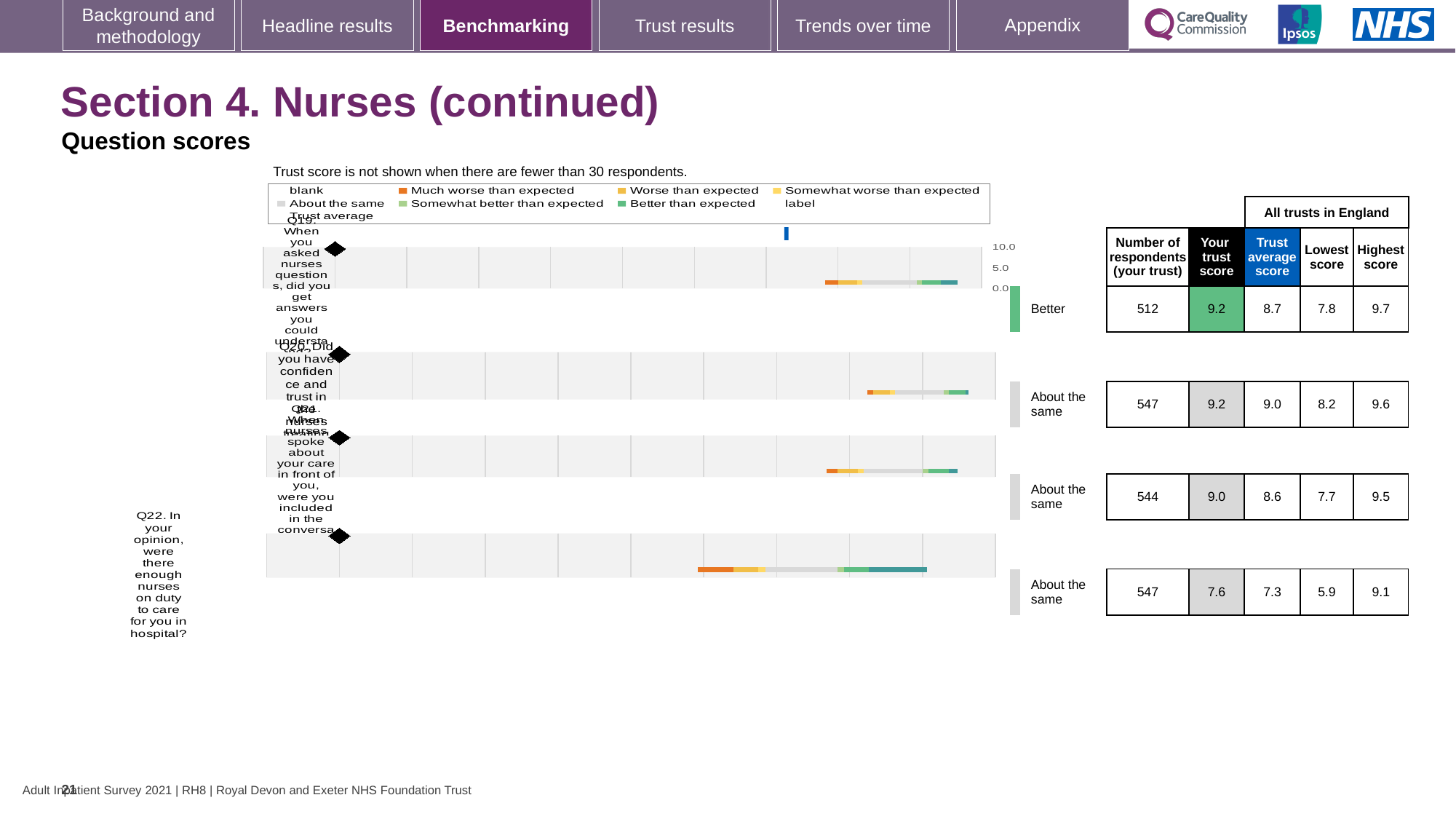
How many questions are shown on this slide? 4 What is the trust score for Q22 (were there enough nurses on duty to care for you in hospital)? 7.6 What is the trust average score for Q19 (when you asked nurses questions, did you get answers you could understand)? 8.7 Which question has the lowest trust score on this slide? Q22 What is the lowest score across all trusts in England for Q22? 5.9 What is the difference between the highest score and the lowest score for Q22? 3.2 What kind of chart is used to show the question scores? Bar chart How many respondents answered Q21 at this trust? 544 What is the highest score across all trusts in England for Q20? 9.6 Which has the higher trust score, Q19 or Q21? Q19 Which question is rated 'Better' rather than 'About the same'? Q19 What is the difference between the trust score and the trust average score for Q22? 0.3